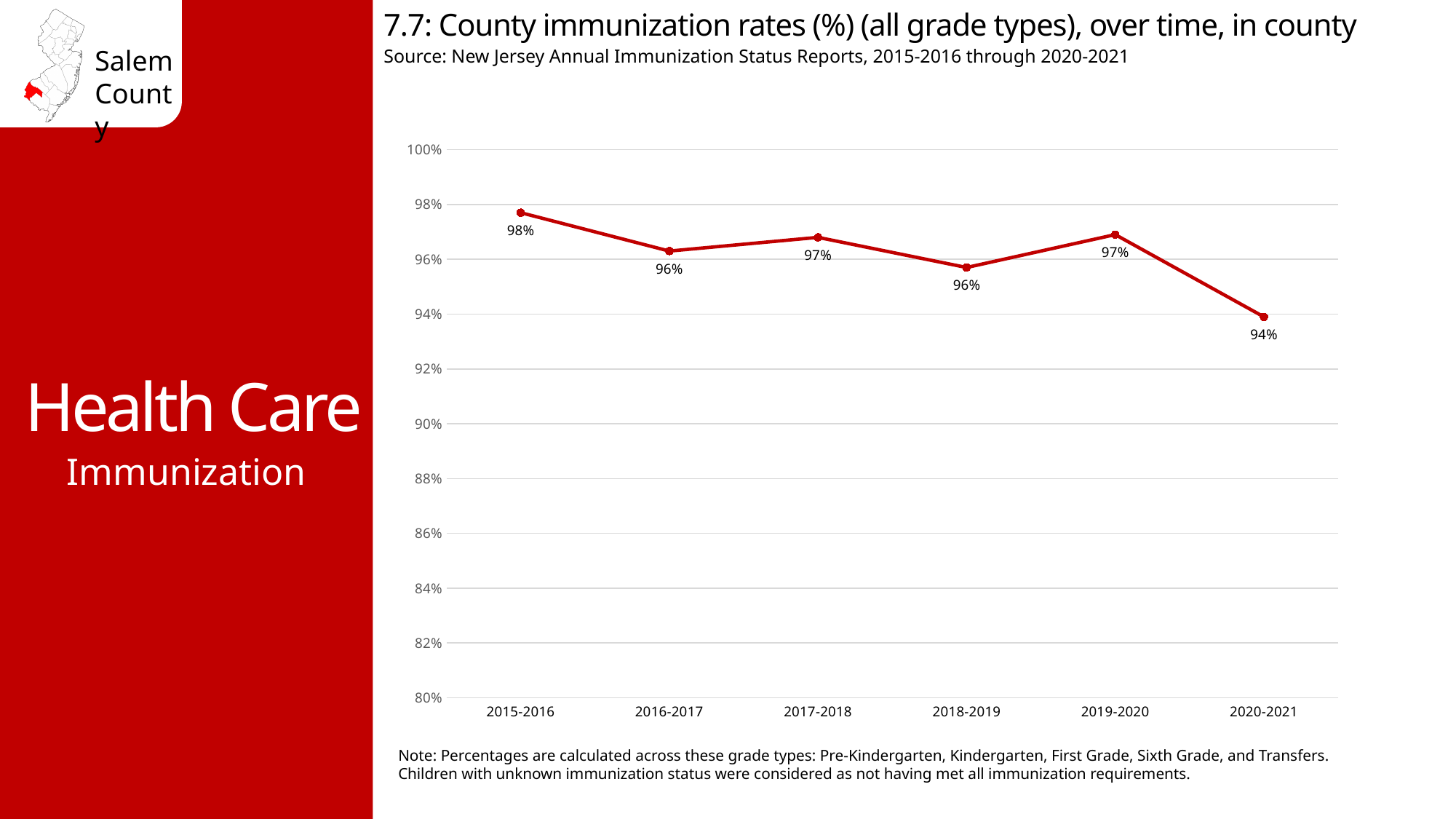
What is the difference in percentage points between the immunization rate in 2015-2016 and in 2020-2021? 4 percentage points Overall, do the immunization rates rise or fall from 2015-2016 to 2020-2021? fall How many school years are plotted on the chart? 6 Which school year had the highest immunization rate? 2015-2016 What was the county immunization rate in 2017-2018? 97% Which school year had the lowest immunization rate? 2020-2021 What was the county immunization rate in 2020-2021? 94% What was the county immunization rate in 2018-2019? 96% Which year had a higher immunization rate, 2019-2020 or 2020-2021? 2019-2020 What was the county immunization rate in 2015-2016? 98% What kind of chart is shown on the slide? line chart Is the immunization rate for 2020-2021 greater or less than 96%? less